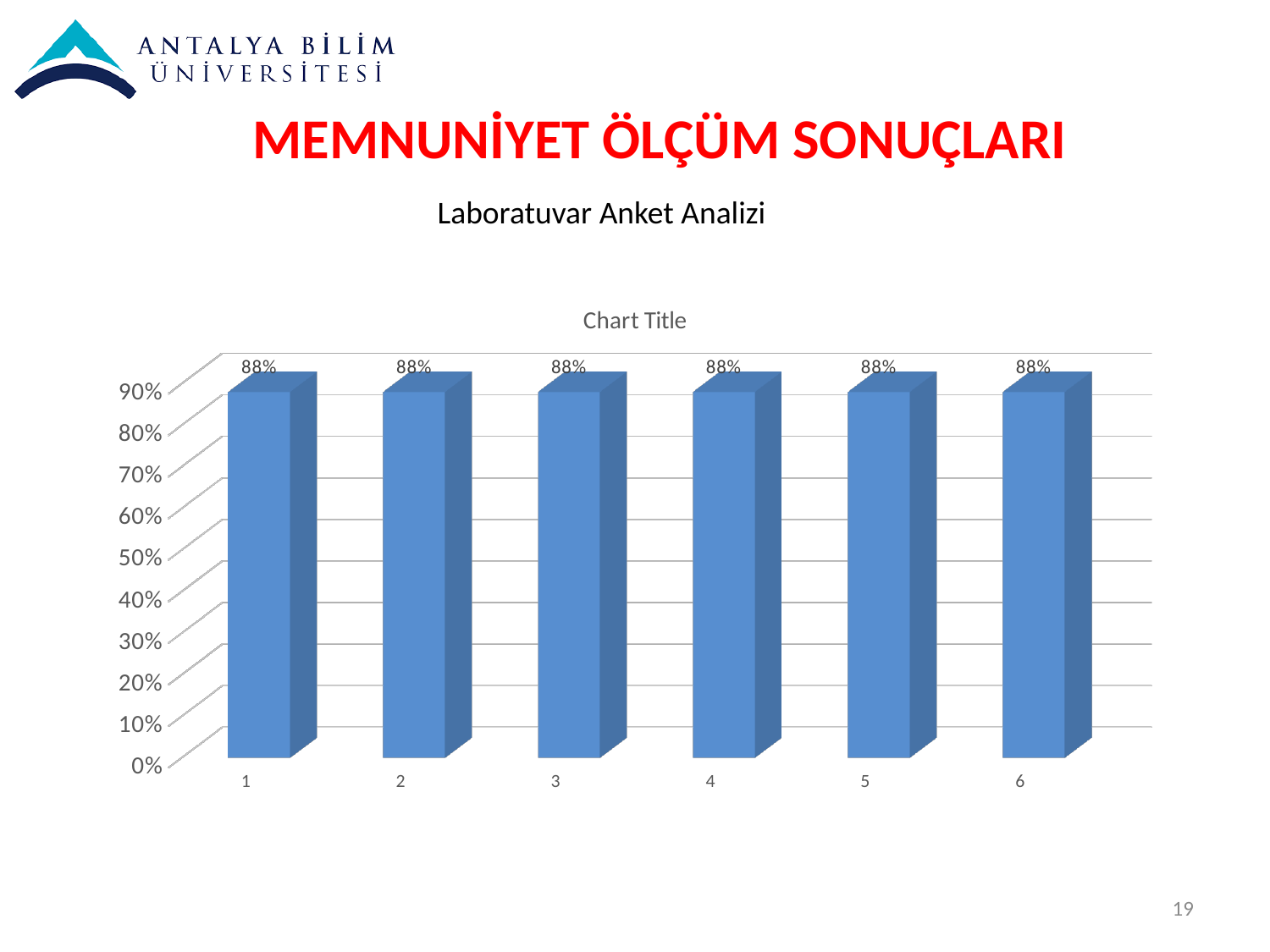
What is the value for category 1? 88% What is the difference between the values for category 2 and category 5? 0% Do the values rise, fall, or stay the same from category 1 to category 6? stay the same What is the subtitle of the slide above the chart? Laboratuvar Anket Analizi Is the value for category 3 greater or less than 80%? greater What is the title shown above the chart? Chart Title What is the highest value shown on the y axis? 90% What is the value for category 6? 88% What is the value for category 4? 88% What kind of chart is shown on the slide? bar chart Is the value for category 5 greater or less than 90%? less How many categories are shown on the x axis? 6